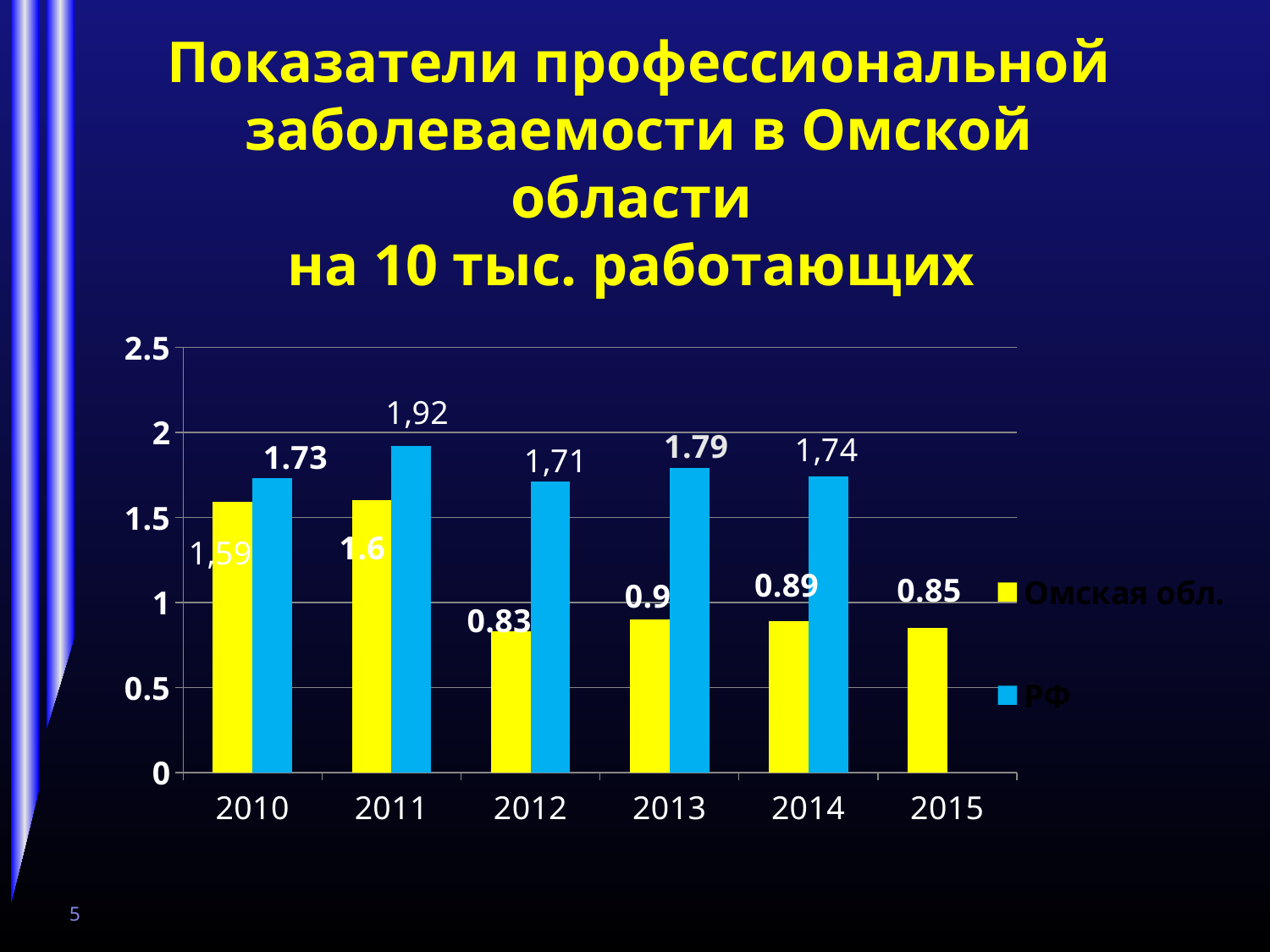
Which is larger in 2012, the value for Омская обл. or for РФ? РФ What is the value for Омская обл. in 2015? 0.85 What is the value for Омская обл. in 2012? 0.83 What is the difference between the РФ value and the Омская обл. value in 2013? 0.89 In which year is the РФ value highest? 2011 What kind of chart is shown on the slide? bar chart How many series does the legend list? 2 What is the value for РФ in 2011? 1,92 How many years are shown on the x axis? 6 Do the values for Омская обл. generally rise or fall from 2010 to 2015? fall Is the value for РФ in 2013 greater or less than 1.5? greater What is the value for РФ in 2014? 1,74